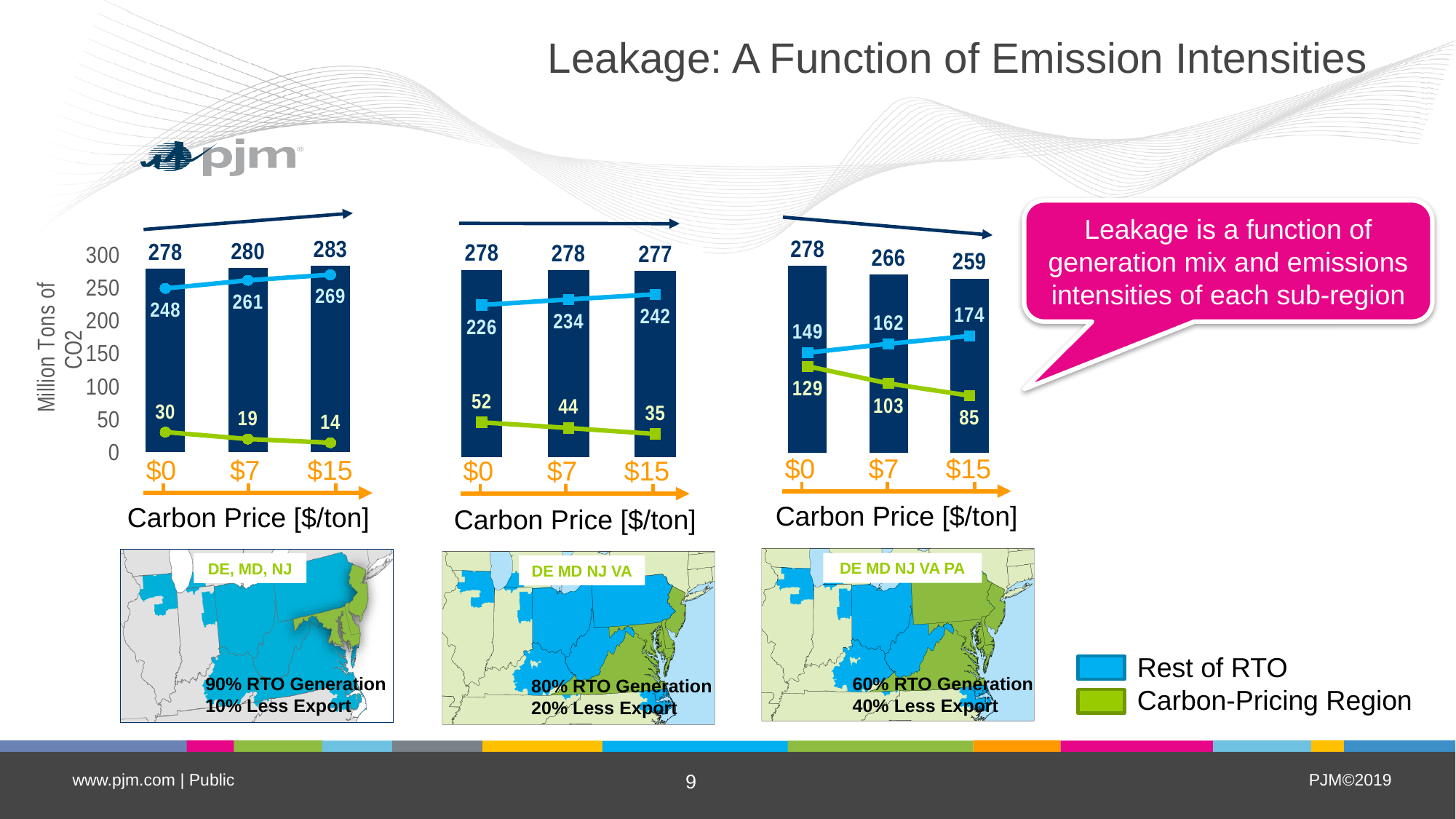
In the right chart (DE MD NJ VA PA), what is the Carbon-Pricing Region value at a carbon price of $0? 129 How many series does the legend at the bottom right list? 2 What is the y-axis label shared by the charts? Million Tons of CO2 In the right chart (DE MD NJ VA PA), is the Rest of RTO value at $0 larger or smaller than the Carbon-Pricing Region value at $0? larger In the left chart (DE, MD, NJ), what is the difference between the Rest of RTO values at $15 and $0? 21 In the right chart (DE MD NJ VA PA), does the Rest of RTO line rise or fall as the carbon price increases? rise In the left chart (DE, MD, NJ), what is the Carbon-Pricing Region value at a carbon price of $7? 19 In the left chart (DE, MD, NJ), what is the total emissions value shown above the bar at a carbon price of $15? 283 How many carbon price categories are shown on the x axis of each chart? 3 In the right chart (DE MD NJ VA PA), which carbon price has the lowest total emissions bar? $15 In the middle chart (DE MD NJ VA), does the Carbon-Pricing Region line rise or fall as the carbon price increases? fall In the middle chart (DE MD NJ VA), what is the Rest of RTO value at a carbon price of $15? 242